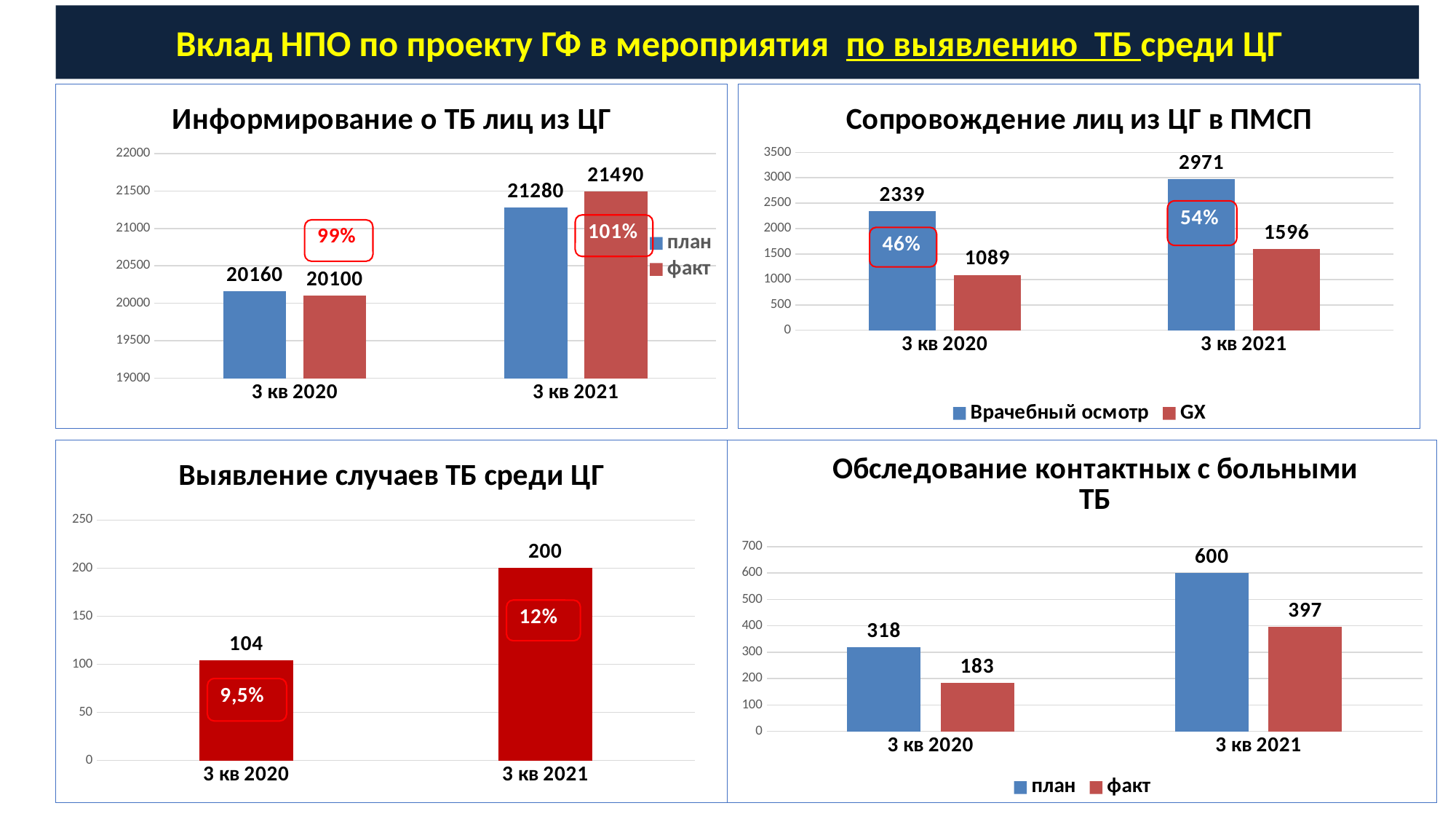
In the chart 'Информирование о ТБ лиц из ЦГ', what is the 'факт' value for 3 кв 2020? 20100 In the chart 'Сопровождение лиц из ЦГ в ПМСП', how many series does the legend list? 2 In the chart 'Сопровождение лиц из ЦГ в ПМСП', what is the 'GX' value for 3 кв 2020? 1089 In the chart 'Выявление случаев ТБ среди ЦГ', what is the value for 3 кв 2020? 104 What kind of chart is 'Обследование контактных с больными ТБ'? bar chart In the chart 'Информирование о ТБ лиц из ЦГ', what is the difference between 'факт' and 'план' for 3 кв 2021? 210 In the chart 'Выявление случаев ТБ среди ЦГ', what is the difference between the 3 кв 2021 and 3 кв 2020 values? 96 In the chart 'Информирование о ТБ лиц из ЦГ', what is the 'план' value for 3 кв 2021? 21280 In the chart 'Сопровождение лиц из ЦГ в ПМСП', what is the 'Врачебный осмотр' value for 3 кв 2021? 2971 In the chart 'Обследование контактных с больными ТБ', which is larger for 3 кв 2020: 'план' or 'факт'? план In the chart 'Обследование контактных с больными ТБ', what is the 'факт' value for 3 кв 2021? 397 In the chart 'Выявление случаев ТБ среди ЦГ', do the values rise or fall from 3 кв 2020 to 3 кв 2021? rise